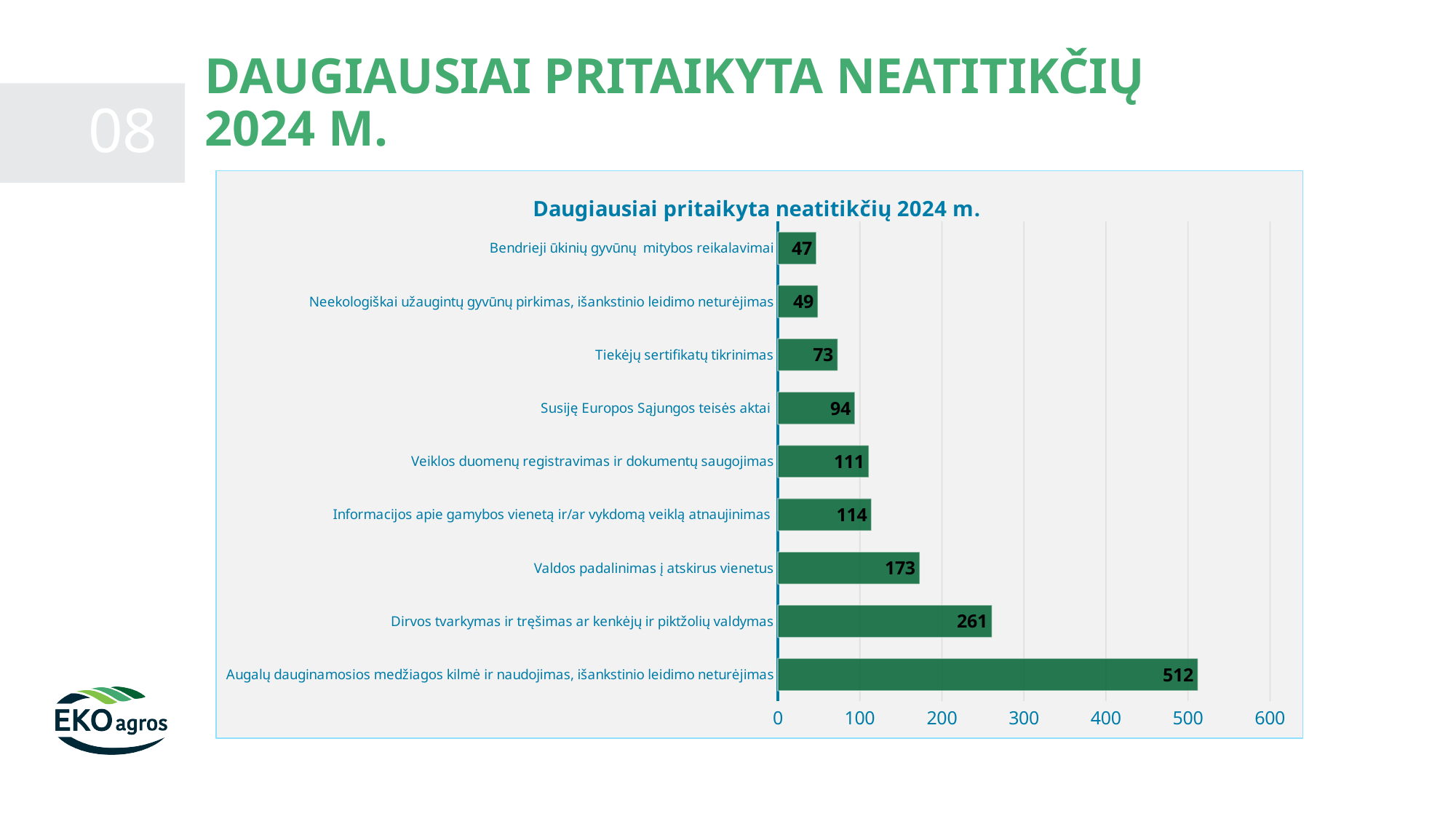
How many categories are shown in the chart? 9 Which is larger: the value for "Veiklos duomenų registravimas ir dokumentų saugojimas" or for "Informacijos apie gamybos vienetą ir/ar vykdomą veiklą atnaujinimas"? Informacijos apie gamybos vienetą ir/ar vykdomą veiklą atnaujinimas What is the value for "Susiję Europos Sąjungos teisės aktai"? 94 What is the difference between the values for "Dirvos tvarkymas ir tręšimas ar kenkėjų ir piktžolių valdymas" and "Valdos padalinimas į atskirus vienetus"? 88 What is the highest value shown on the x axis? 600 What is the value for "Tiekėjų sertifikatų tikrinimas"? 73 What is the value for "Valdos padalinimas į atskirus vienetus"? 173 What is the title of the chart? Daugiausiai pritaikyta neatitikčių 2024 m. Which category has the lowest value? Bendrieji ūkinių gyvūnų mitybos reikalavimai Which category has the highest value? Augalų dauginamosios medžiagos kilmė ir naudojimas, išankstinio leidimo neturėjimas Is the value for "Dirvos tvarkymas ir tręšimas ar kenkėjų ir piktžolių valdymas" greater or less than 300? less What kind of chart is shown on the slide? bar chart